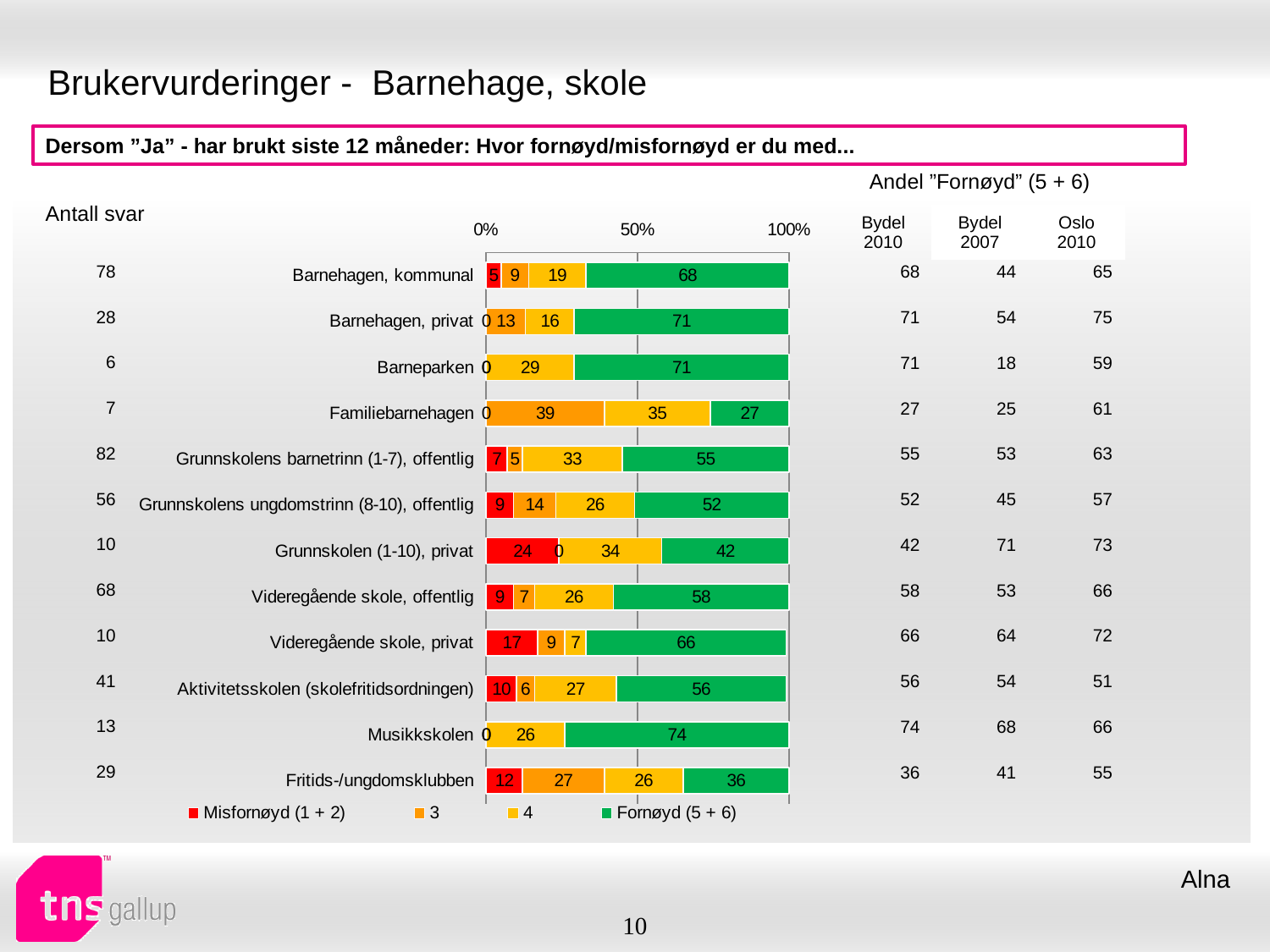
What is the value of the '4' segment for Videregående skole, privat? 7 What is the Misfornøyd (1 + 2) value for Grunnskolen (1-10), privat? 24 What is the Fornøyd (5 + 6) value for Barnehagen, kommunal? 68 How many series does the legend list? 4 Which category has the highest Fornøyd (5 + 6) value? Musikkskolen Which category has the lowest Fornøyd (5 + 6) value? Familiebarnehagen What is the difference between the Fornøyd (5 + 6) values for Barnehagen, privat and Barnehagen, kommunal? 3 How many categories are shown in the bar chart? 12 Is the Fornøyd (5 + 6) value for Familiebarnehagen greater or less than 50? less Which has a larger Fornøyd (5 + 6) value: Videregående skole, offentlig or Aktivitetsskolen (skolefritidsordningen)? Videregående skole, offentlig Which category has the highest Misfornøyd (1 + 2) value? Grunnskolen (1-10), privat What kind of chart is shown on the slide? Stacked bar chart